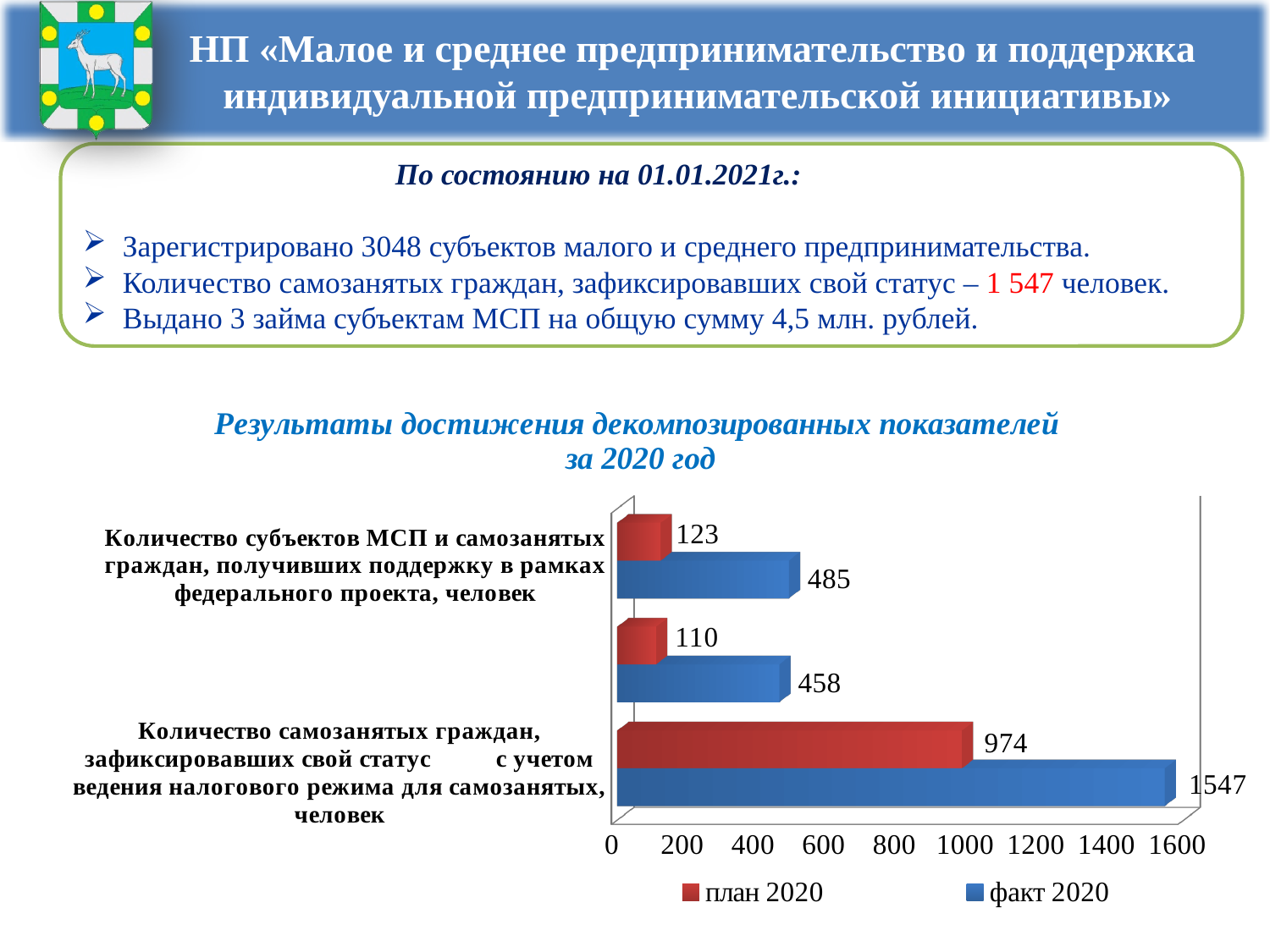
What are the two series named in the chart legend? план 2020 and факт 2020 What kind of chart is shown on the slide? bar chart By how much does 'факт 2020' exceed 'план 2020' for 'Количество самозанятых граждан, зафиксировавших свой статус с учетом ведения налогового режима для самозанятых, человек'? 573 By how much does 'факт 2020' exceed 'план 2020' for 'Количество субъектов МСП и самозанятых граждан, получивших поддержку в рамках федерального проекта, человек'? 362 Which is larger for 'Количество субъектов МСП и самозанятых граждан, получивших поддержку в рамках федерального проекта, человек': 'план 2020' or 'факт 2020'? факт 2020 What is the 'план 2020' value for 'Количество субъектов МСП и самозанятых граждан, получивших поддержку в рамках федерального проекта, человек'? 123 How many series does the chart legend list? 2 Which bar in the chart has the highest value? факт 2020 for Количество самозанятых граждан, зафиксировавших свой статус (1547) What colour are the 'план 2020' bars in the chart? red What is the 'факт 2020' value for 'Количество субъектов МСП и самозанятых граждан, получивших поддержку в рамках федерального проекта, человек'? 485 What is the 'факт 2020' value for 'Количество самозанятых граждан, зафиксировавших свой статус с учетом ведения налогового режима для самозанятых, человек'? 1547 What is the 'план 2020' value for 'Количество самозанятых граждан, зафиксировавших свой статус с учетом ведения налогового режима для самозанятых, человек'? 974